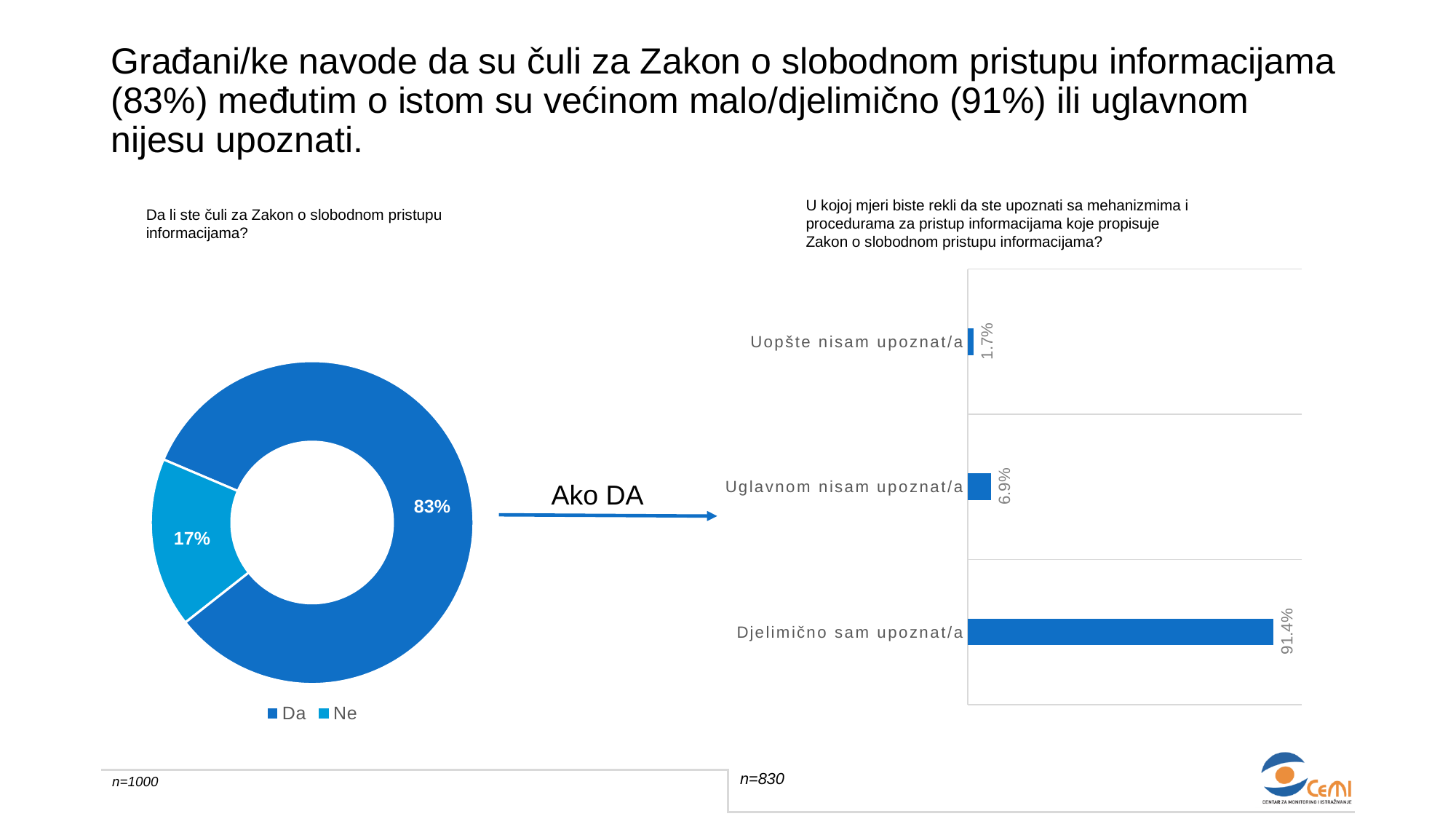
In the left chart (Da li ste čuli za Zakon o slobodnom pristupu informacijama?), what share of respondents answered Da? 83% What kind of chart is the right chart on the slide? Bar chart In the right chart (U kojoj mjeri biste rekli da ste upoznati...), what is the value for Uopšte nisam upoznat/a? 1.7% In the left chart, which answer has the larger share, Da or Ne? Da In the right chart, how many categories are shown? 3 In the left chart, what is the difference in percentage points between Da and Ne? 66 percentage points How many entries does the legend of the left chart list? 2 In the right chart, which category has the lowest value? Uopšte nisam upoznat/a In the right chart (U kojoj mjeri biste rekli da ste upoznati...), what is the value for Uglavnom nisam upoznat/a? 6.9% In the left chart (Da li ste čuli za Zakon o slobodnom pristupu informacijama?), what share of respondents answered Ne? 17% What kind of chart is the left chart on the slide? Doughnut (pie) chart In the right chart (U kojoj mjeri biste rekli da ste upoznati...), what is the value for Djelimično sam upoznat/a? 91.4%